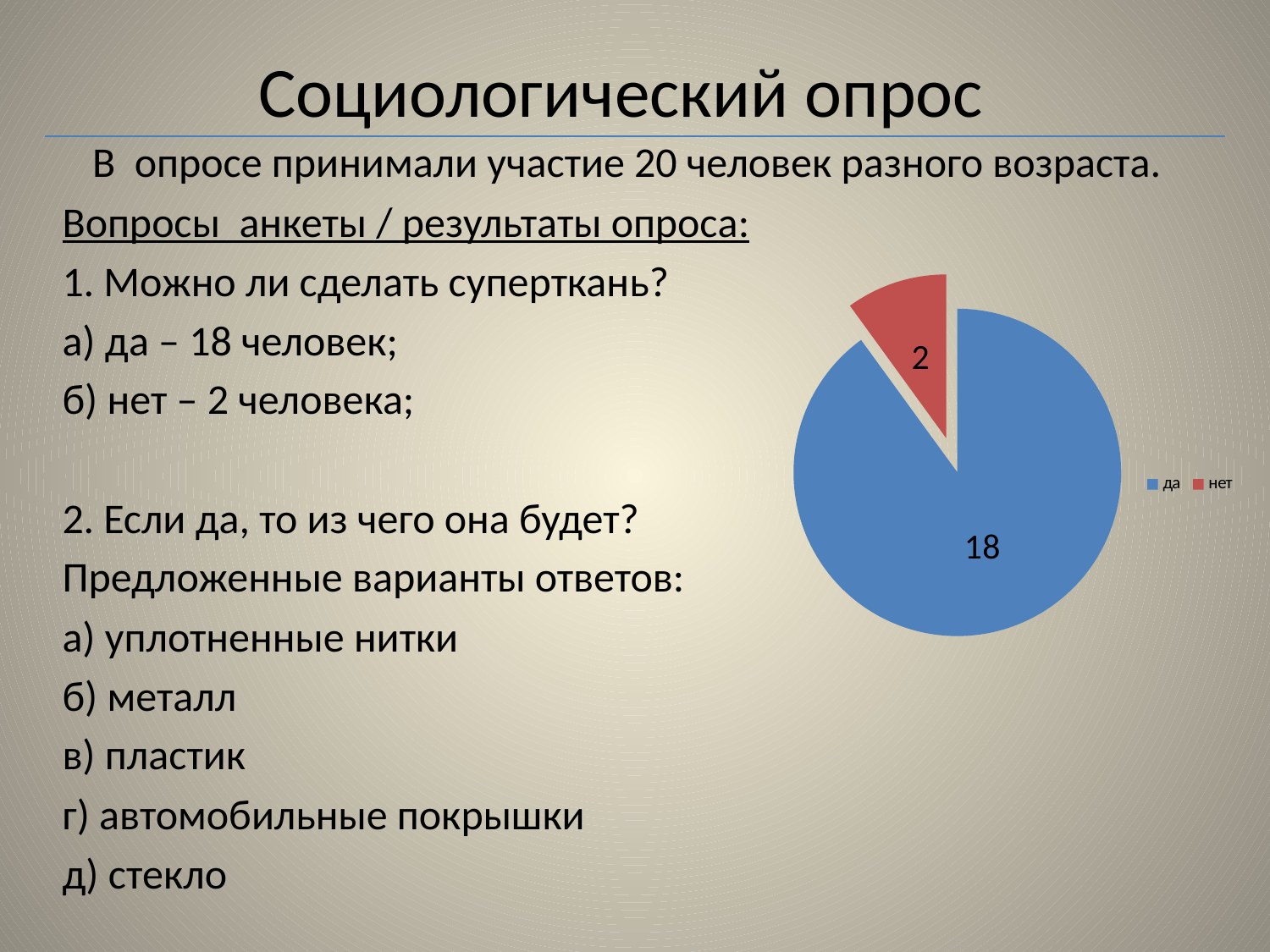
What is the value for the "нет" slice of the pie chart? 2 Which is larger in the pie chart, "да" or "нет"? да Which slice of the pie chart is the largest? да What share of the pie chart does the "да" slice represent? 90% What is the difference between the "да" and "нет" values in the pie chart? 16 How many entries does the legend of the pie chart list? 2 What is the total of all slices in the pie chart? 20 How many slices does the pie chart have? 2 What is the value for the "да" slice of the pie chart? 18 Which slice of the pie chart is the smallest? нет What kind of chart is shown on the slide? pie chart What colour is the "нет" slice in the pie chart? red